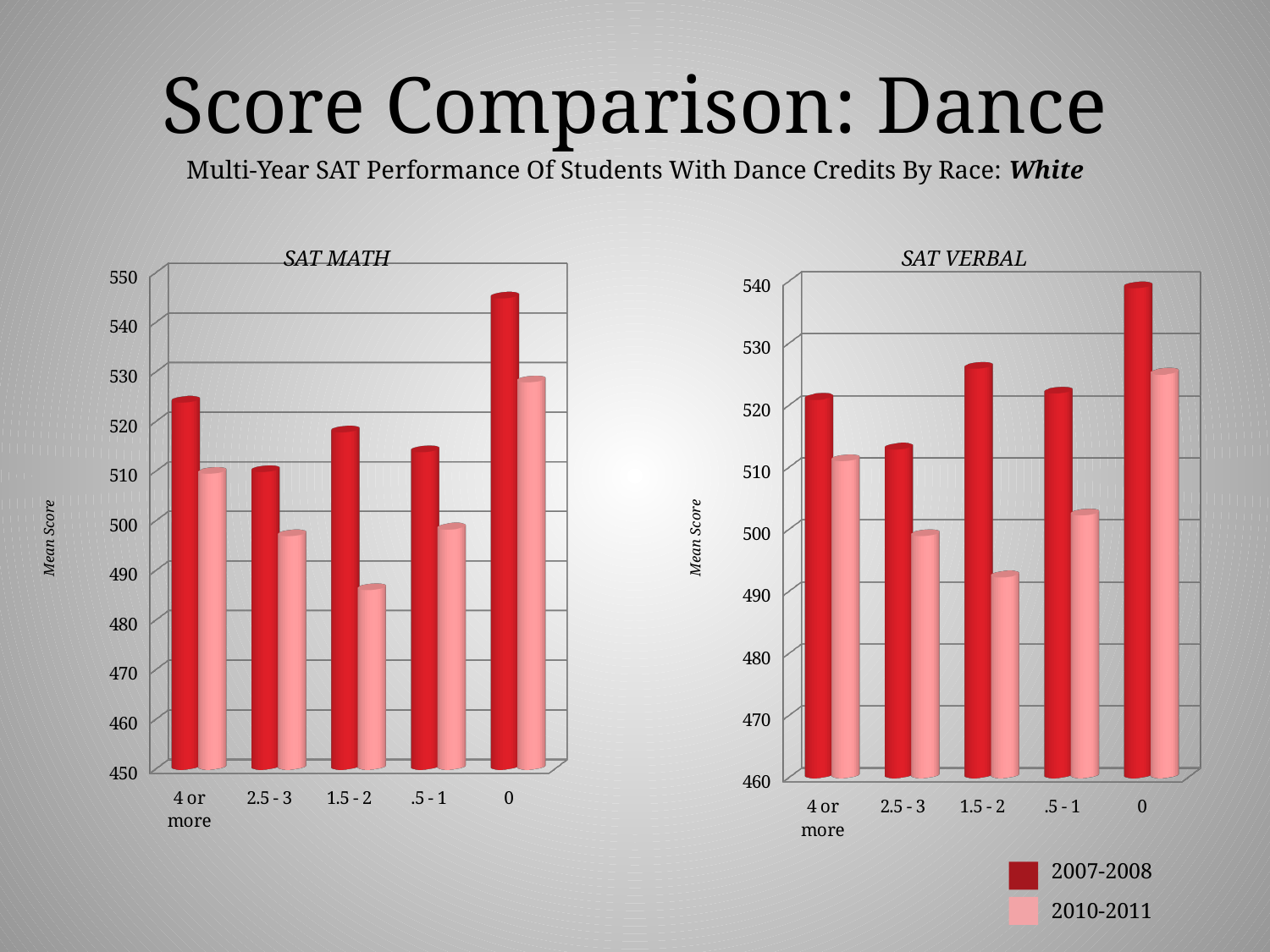
In the SAT VERBAL chart, which category has the lowest 2007-2008 score? 2.5 - 3 What kind of chart is the SAT MATH chart? bar chart What is the label on the vertical axis of the SAT MATH chart? Mean Score In the SAT MATH chart, is the 2007-2008 value for the 0 category greater or less than 540? greater In the SAT VERBAL chart, is the 2010-2011 value for 1.5 - 2 greater or less than 500? less In the SAT MATH chart, which category has the lowest 2010-2011 score? 1.5 - 2 In the SAT VERBAL chart, which category has the highest 2010-2011 score? 0 In the SAT VERBAL chart, is the 2007-2008 score for 1.5 - 2 higher or lower than the 2007-2008 score for 2.5 - 3? higher How many categories are shown on the x axis of the SAT VERBAL chart? 5 In the SAT MATH chart, which category has the highest 2007-2008 score? 0 In the SAT MATH chart, which is larger for the 4 or more category: the 2007-2008 score or the 2010-2011 score? 2007-2008 How many series does the legend list? 2